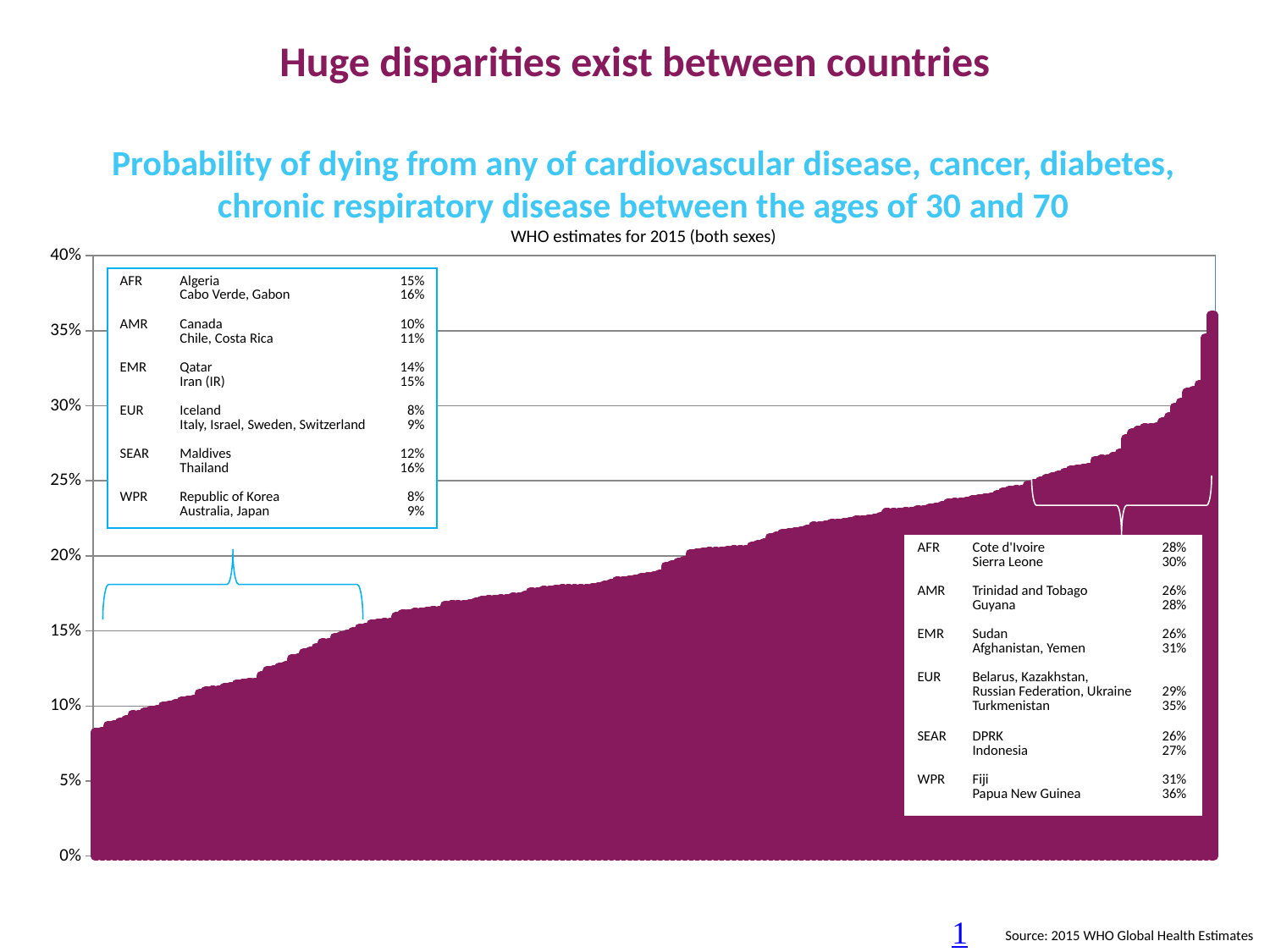
Is the value of the leftmost (lowest) point on the chart greater or less than 10%? less What is the difference between the probability for Fiji and the probability for Republic of Korea, as listed in the annotation boxes? 23 percentage points Which has the higher probability according to the annotation box, Guyana or Sudan? Guyana According to the annotation box, what is the probability for Canada? 10% What is the lowest probability value listed in the annotation boxes? 8% Do the plotted values rise or fall from left to right along the x axis? rise What is the subtitle printed directly above the chart area? WHO estimates for 2015 (both sexes) According to the annotation box, what is the probability for Indonesia? 27% According to the annotation box, what is the probability for Turkmenistan? 35% What is the highest value shown on the y axis? 40% Which country listed in the annotation boxes has the highest probability? Papua New Guinea According to the annotation box, what is the probability for Maldives? 12%